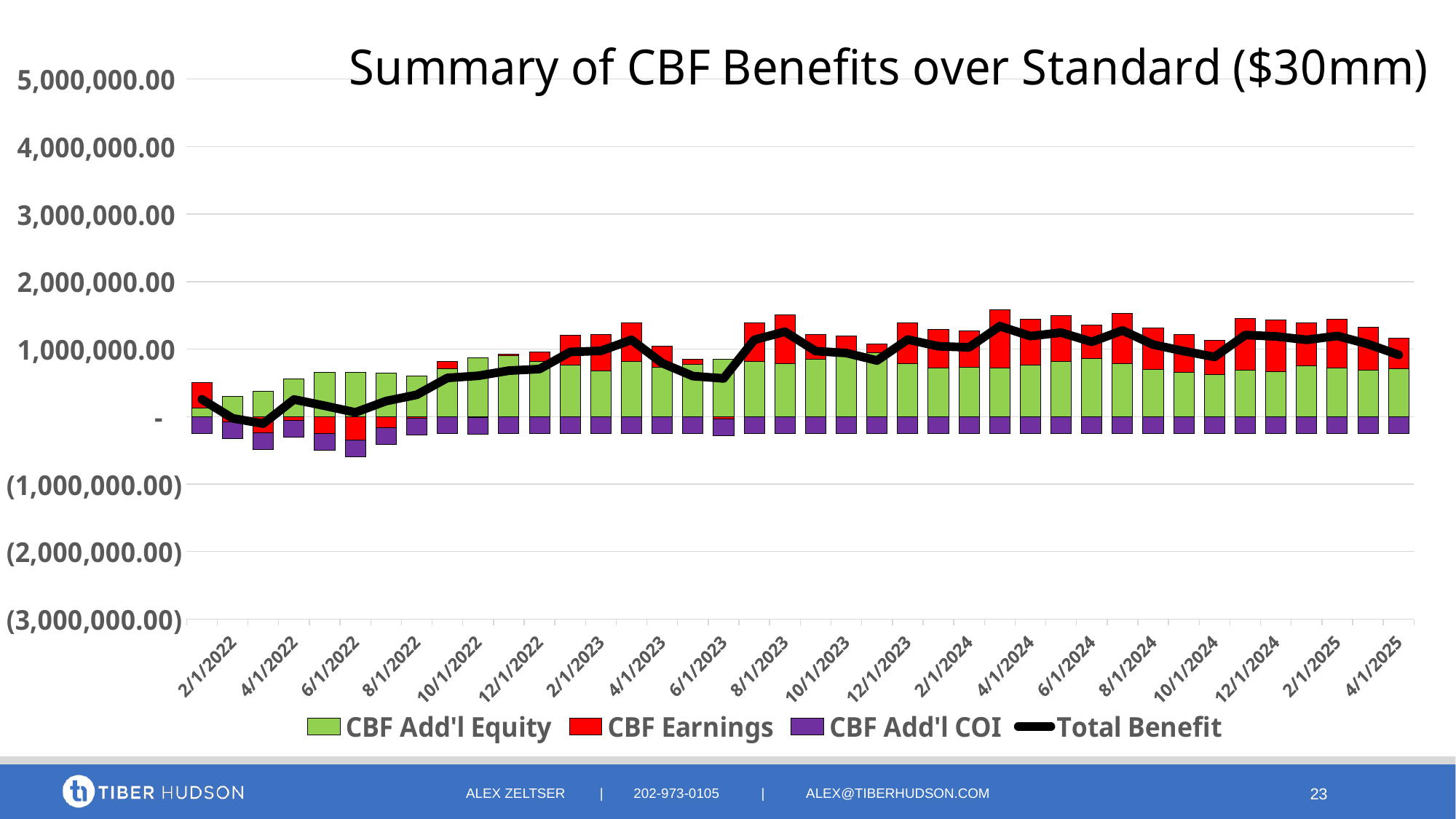
Which series is drawn as a black line? Total Benefit Is the Total Benefit value for 4/1/2024 larger or smaller than the value for 6/1/2023? larger Is the Total Benefit value for 4/1/2023 greater or less than 1,000,000.00? less What kind of chart is this? Stacked bar chart with a line overlay Does the Total Benefit line generally rise or fall from 2/1/2022 to 4/1/2025? rise Is the Total Benefit value for 4/1/2024 greater or less than 1,000,000.00? greater Is the Total Benefit value for 6/1/2023 greater or less than 1,000,000.00? less How many series does the legend list? 4 How many date labels are shown on the x axis? 20 What is the title of the chart? Summary of CBF Benefits over Standard ($30mm)